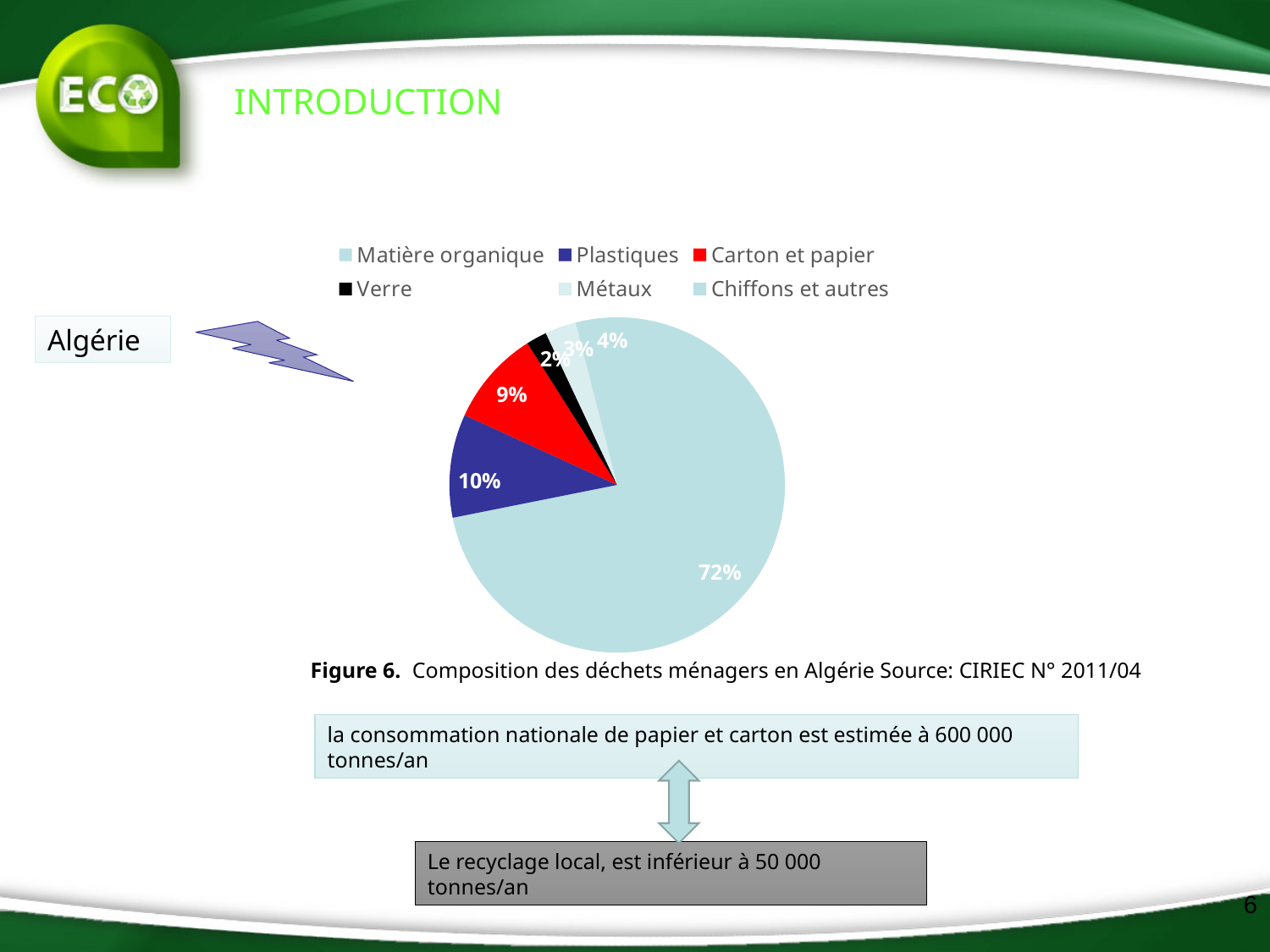
What percentage is shown for Chiffons et autres? 4% What is the figure caption of the chart? Figure 6. Composition des déchets ménagers en Algérie Source: CIRIEC N° 2011/04 What type of chart is shown on the slide? Pie chart What percentage is shown for Carton et papier? 9% How many categories does the pie chart show? 6 What percentage is shown for Plastiques? 10% Which colour represents Carton et papier in the pie chart? Red What is the difference in percentage points between Matière organique and Plastiques? 62 Which category has the smallest slice of the pie? Verre Which category has the largest slice of the pie? Matière organique Which is larger, the share for Plastiques or the share for Carton et papier? Plastiques What share of the pie does Matière organique represent? 72%